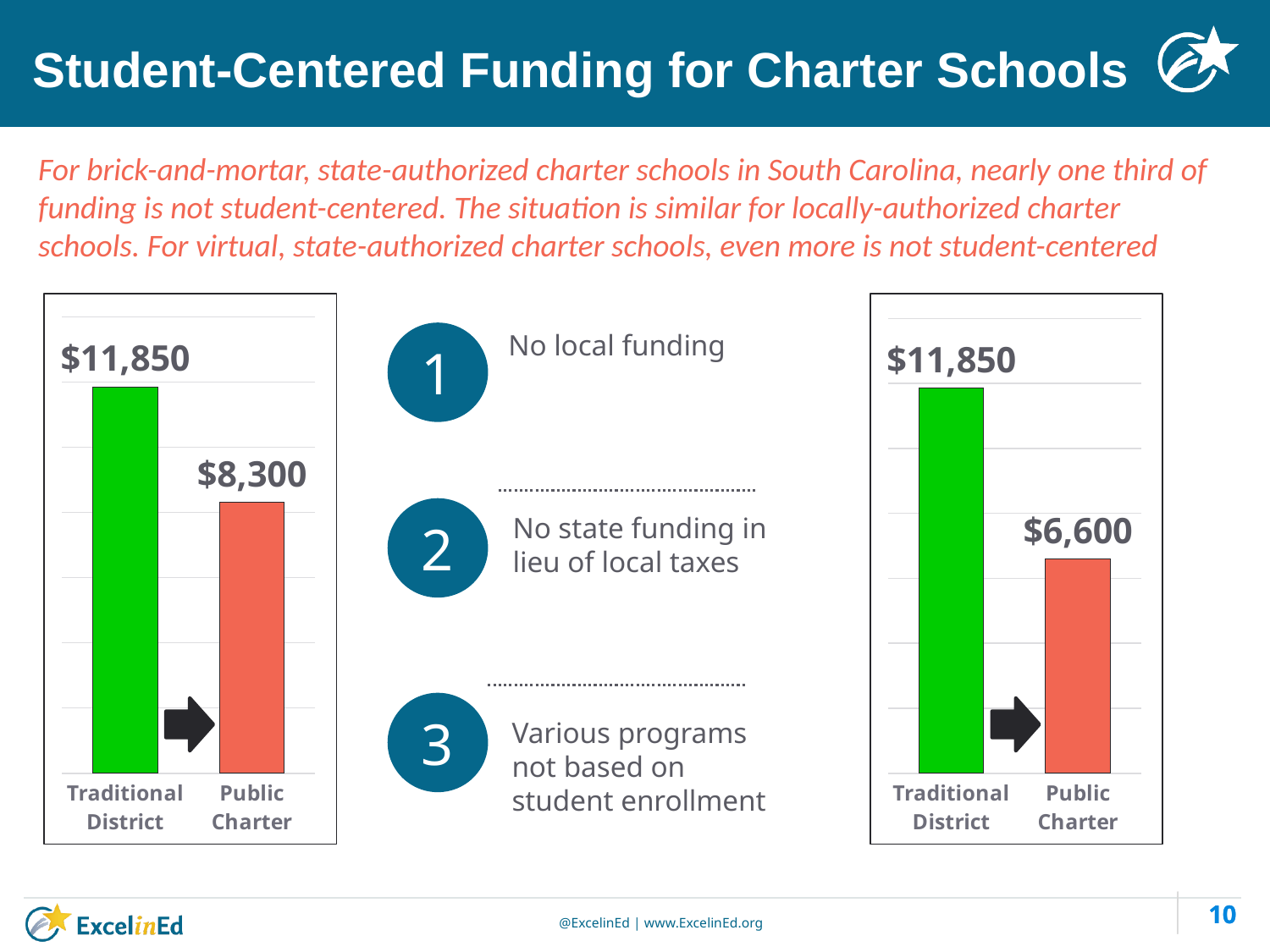
In the left chart, what is the value for Traditional District? $11,850 What kind of chart is the left chart? bar chart In the right chart, what is the value for Traditional District? $11,850 In the left chart, what is the value for Public Charter? $8,300 In the left chart, which category has the highest value? Traditional District In the left chart, what colour is the Public Charter bar? red In the right chart, what is the value for Public Charter? $6,600 How many categories are shown in the right chart? 2 In the right chart, what is the difference between the Traditional District and Public Charter values? $5,250 Is the Public Charter value in the left chart larger or smaller than the Public Charter value in the right chart? larger In the left chart, what is the difference between the Traditional District and Public Charter values? $3,550 In the right chart, which category has the lowest value? Public Charter